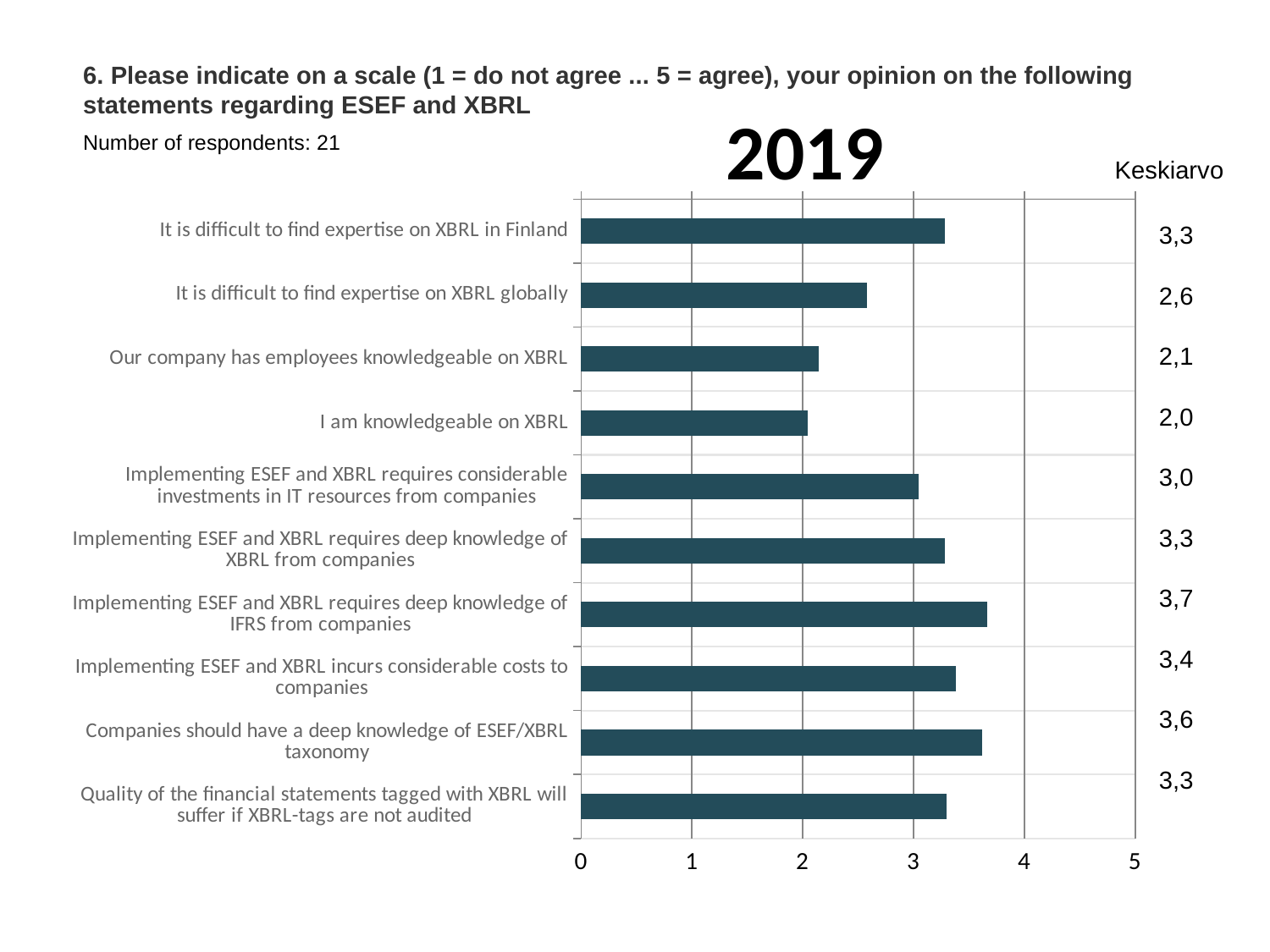
Which statement has the highest average value? Implementing ESEF and XBRL requires deep knowledge of IFRS from companies How many statements (categories) are plotted in the chart? 10 What is the average value for 'Implementing ESEF and XBRL requires deep knowledge of IFRS from companies'? 3,7 What is the average value for 'I am knowledgeable on XBRL'? 2,0 What is the difference between the highest and lowest average values in the chart? 1,7 What kind of chart is shown on the slide? bar chart Which statement has the lowest average value? I am knowledgeable on XBRL What is the average (Keskiarvo) value for 'It is difficult to find expertise on XBRL in Finland'? 3,3 Is the value for 'Our company has employees knowledgeable on XBRL' greater or less than 3? less What is the title of the chart? 2019 Which has a larger average value: 'Companies should have a deep knowledge of ESEF/XBRL taxonomy' or 'Implementing ESEF and XBRL incurs considerable costs to companies'? Companies should have a deep knowledge of ESEF/XBRL taxonomy What is the difference between the average for 'It is difficult to find expertise on XBRL in Finland' and 'It is difficult to find expertise on XBRL globally'? 0,7